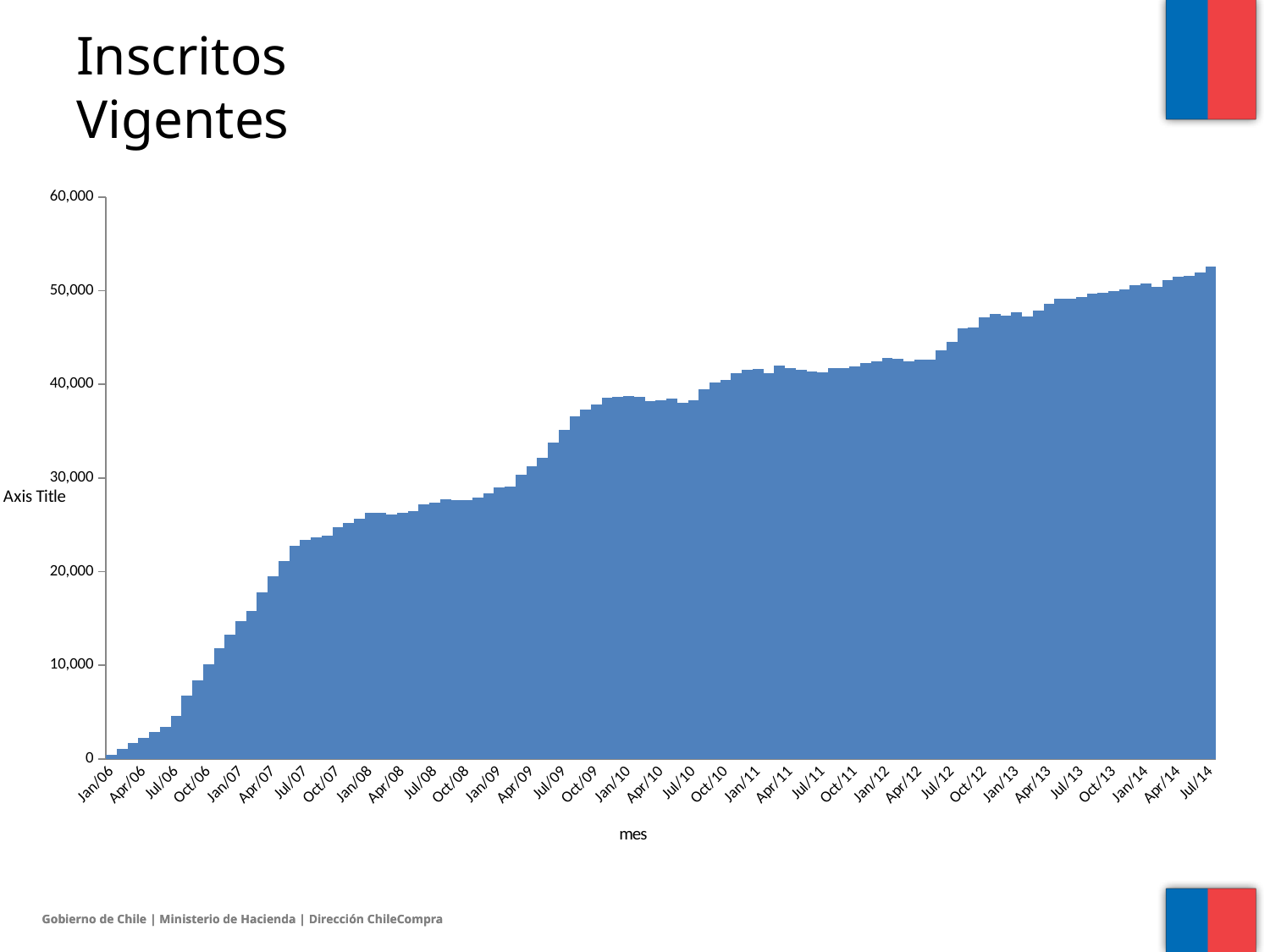
What kind of chart is shown on the slide? bar chart Is the value for Jan/07 greater or less than 20,000? less Is the value for Jan/08 greater or less than 20,000? greater Which month has the lowest value? Jan/06 Which is larger, the value for Jan/07 or the value for Jan/08? Jan/08 Which month has the highest value? Jul/14 Do the values generally rise or fall from Jan/06 to Jul/14? rise What is the title of the chart? Inscritos Vigentes Is the value for Jul/06 greater or less than 10,000? less What is the label on the horizontal axis? mes